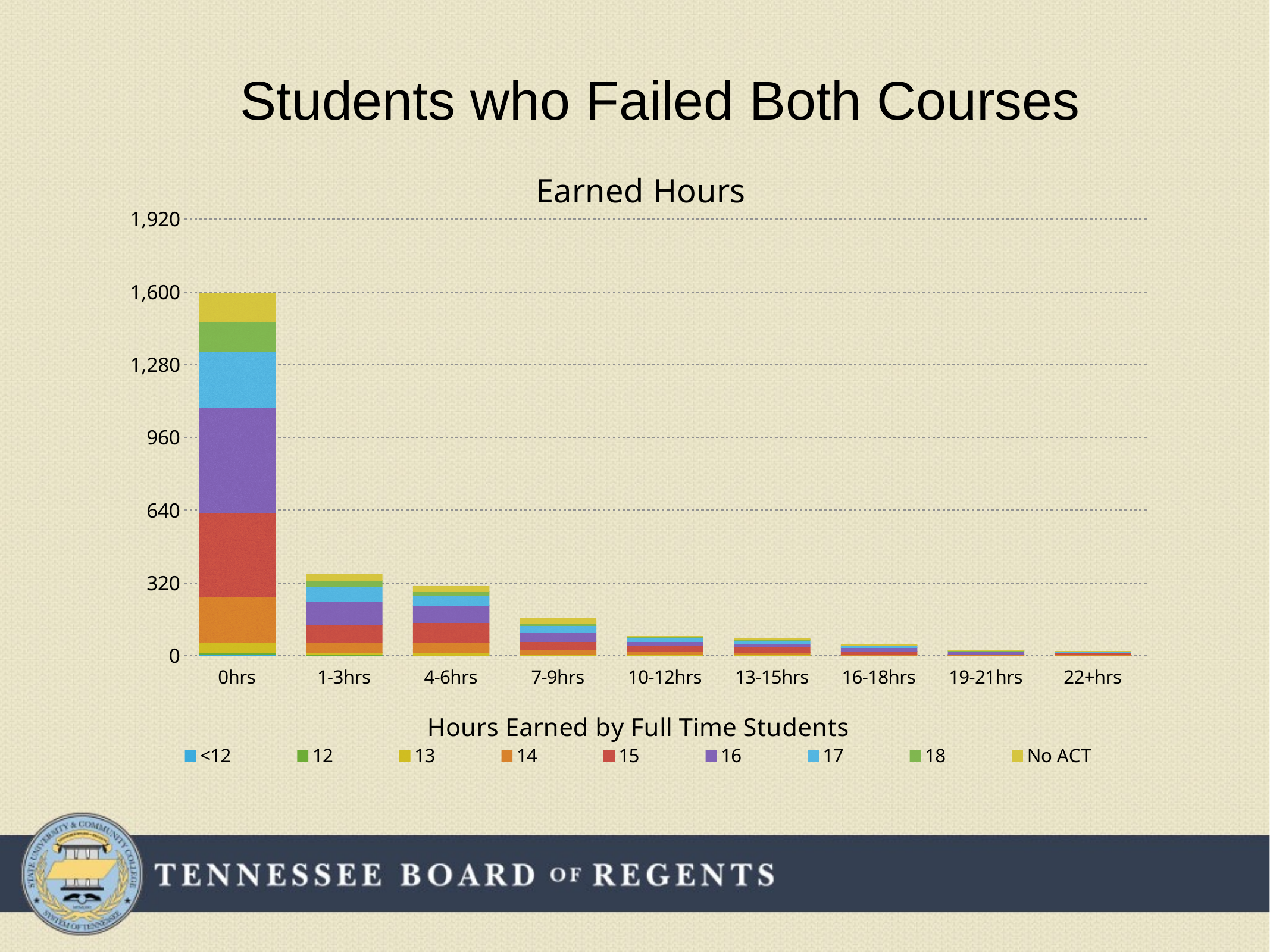
How many categories are shown on the x axis? 9 How many series does the legend list? 9 Which category has the tallest stacked bar? 0hrs Is the total for 1-3hrs greater or less than 320? greater Which stacked bar is taller, 1-3hrs or 4-6hrs? 1-3hrs Is the total for 7-9hrs greater or less than 320? less What is the title of the chart? Earned Hours What is the x axis title of the chart? Hours Earned by Full Time Students Is the total for 0hrs greater or less than 1,280? greater Which category has the shortest stacked bar? 22+hrs Do the stacked bar totals rise or fall moving from 0hrs to 22+hrs along the x axis? fall What kind of chart is shown on the slide? stacked bar chart